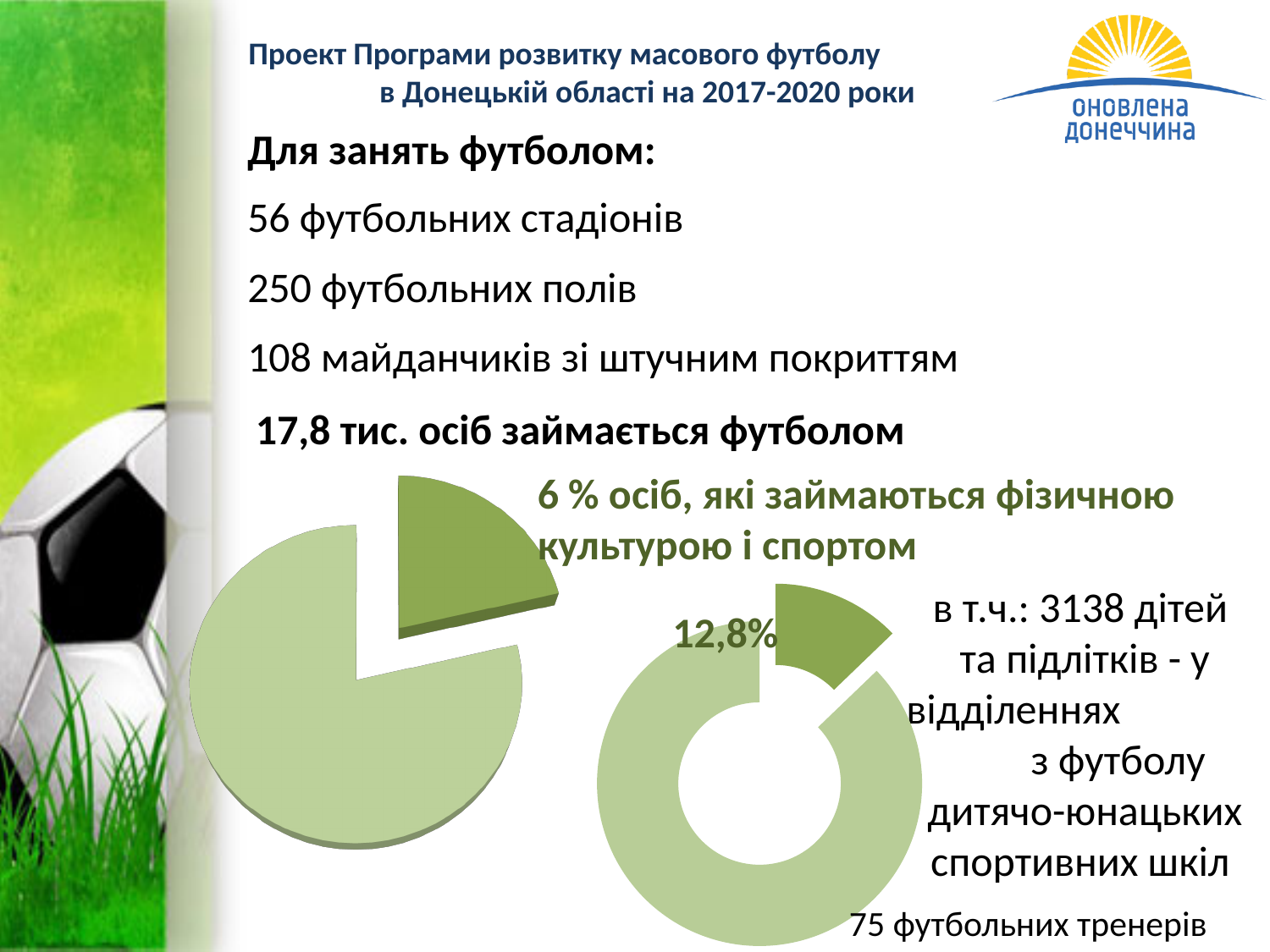
Is the share of the small segment in the doughnut chart on the right greater or less than 50%? less In the doughnut chart on the right, which segment is larger, the dark green one or the light green one? the light green one How many slices does the pie chart on the left have? 2 How many segments does the doughnut chart on the right have? 2 Does the pie chart on the left have a legend? No What percentage is printed next to the small dark green segment of the doughnut chart on the right? 12,8% What kind of chart is the chart on the right of the slide? doughnut chart What share of the pie chart on the left does the exploded slice represent, according to the text beside it? 6 % Is the pie chart on the left drawn in 3D? Yes What kind of chart is the chart on the left of the slide? pie chart In the pie chart on the left, is the exploded dark green slice larger or smaller than the light green slice? smaller